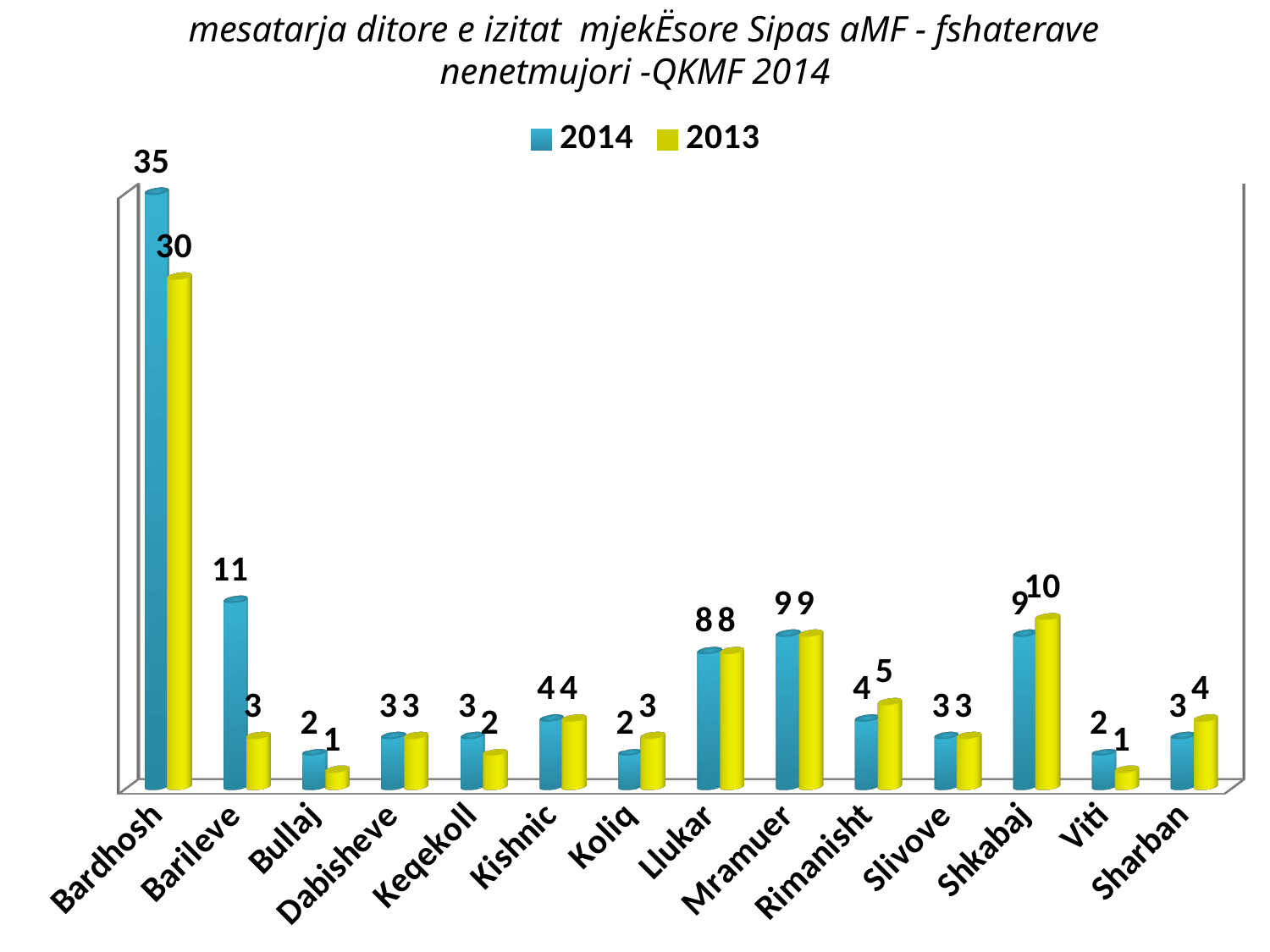
Which category has the highest 2014 value? Bardhosh What kind of chart is shown on the slide? Bar chart How many series does the legend list? 2 Which colour represents the 2013 series in the legend? Yellow Which is larger for Rimanisht, the 2014 value or the 2013 value? 2013 What is the difference between the 2014 and 2013 values for Bardhosh? 5 Which category has the lowest 2013 value? Bullaj and Viti (both 1) What is the difference between the 2014 and 2013 values for Barileve? 8 What is the 2013 value for Shkabaj? 10 What is the 2013 value for Barileve? 3 What is the 2014 value for Bardhosh? 35 How many categories are shown on the x axis? 14